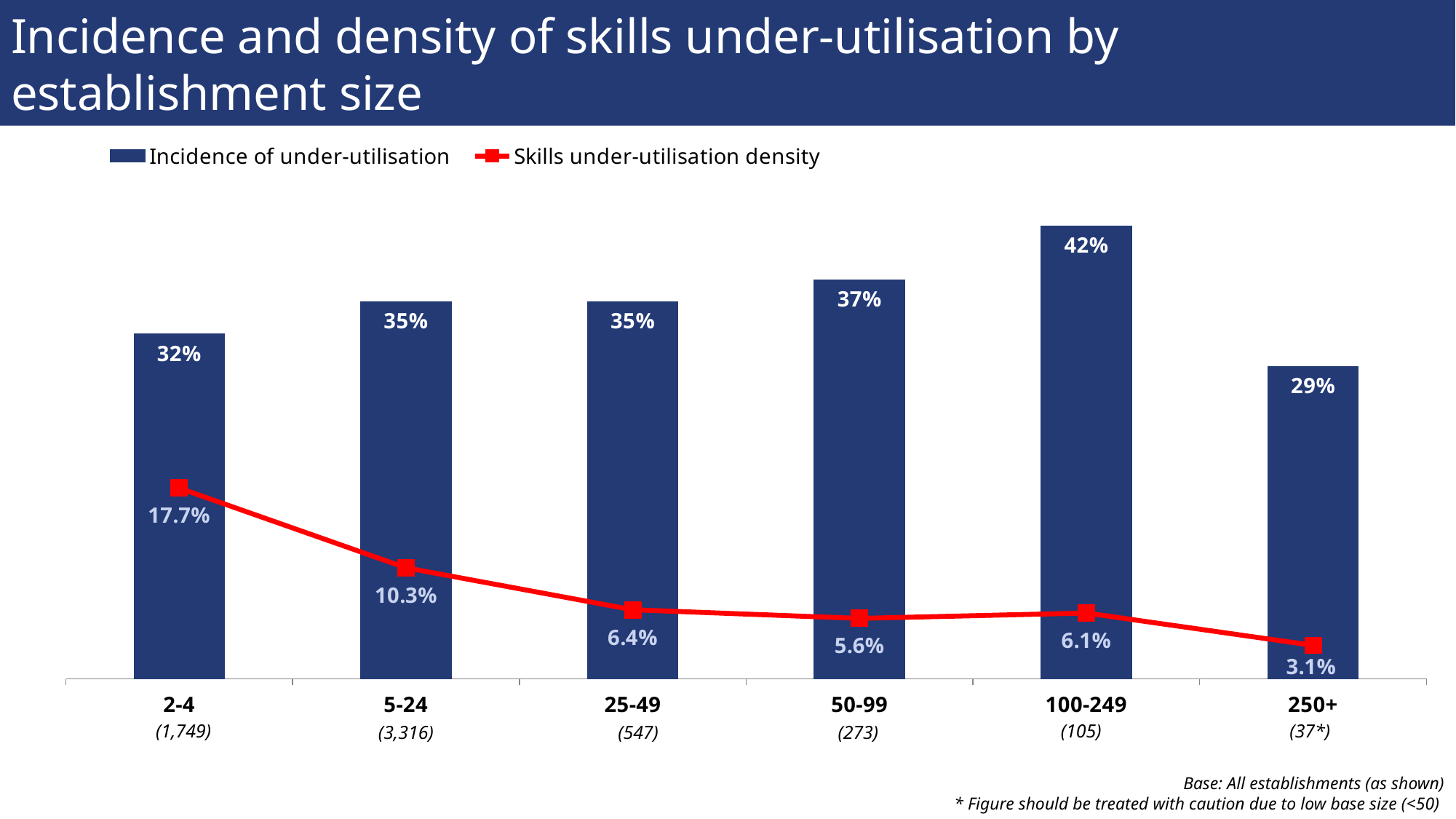
Which establishment size has the lowest skills under-utilisation density? 250+ What is the skills under-utilisation density for establishments with 2-4 employees? 17.7% What is the skills under-utilisation density for establishments with 250+ employees? 3.1% How many establishment size bands are shown on the chart? 6 What kind of chart is used to show the incidence of under-utilisation? Bar chart What colour is the line showing skills under-utilisation density? Red Which has a higher skills under-utilisation density, the 5-24 band or the 50-99 band? 5-24 Which establishment size has the highest incidence of under-utilisation? 100-249 How many series does the legend list? 2 What is the difference in incidence of under-utilisation between the 100-249 and 250+ size bands? 13 percentage points Does the skills under-utilisation density generally rise or fall as establishment size increases from 2-4 to 25-49? Fall What is the incidence of under-utilisation for establishments with 100-249 employees? 42%